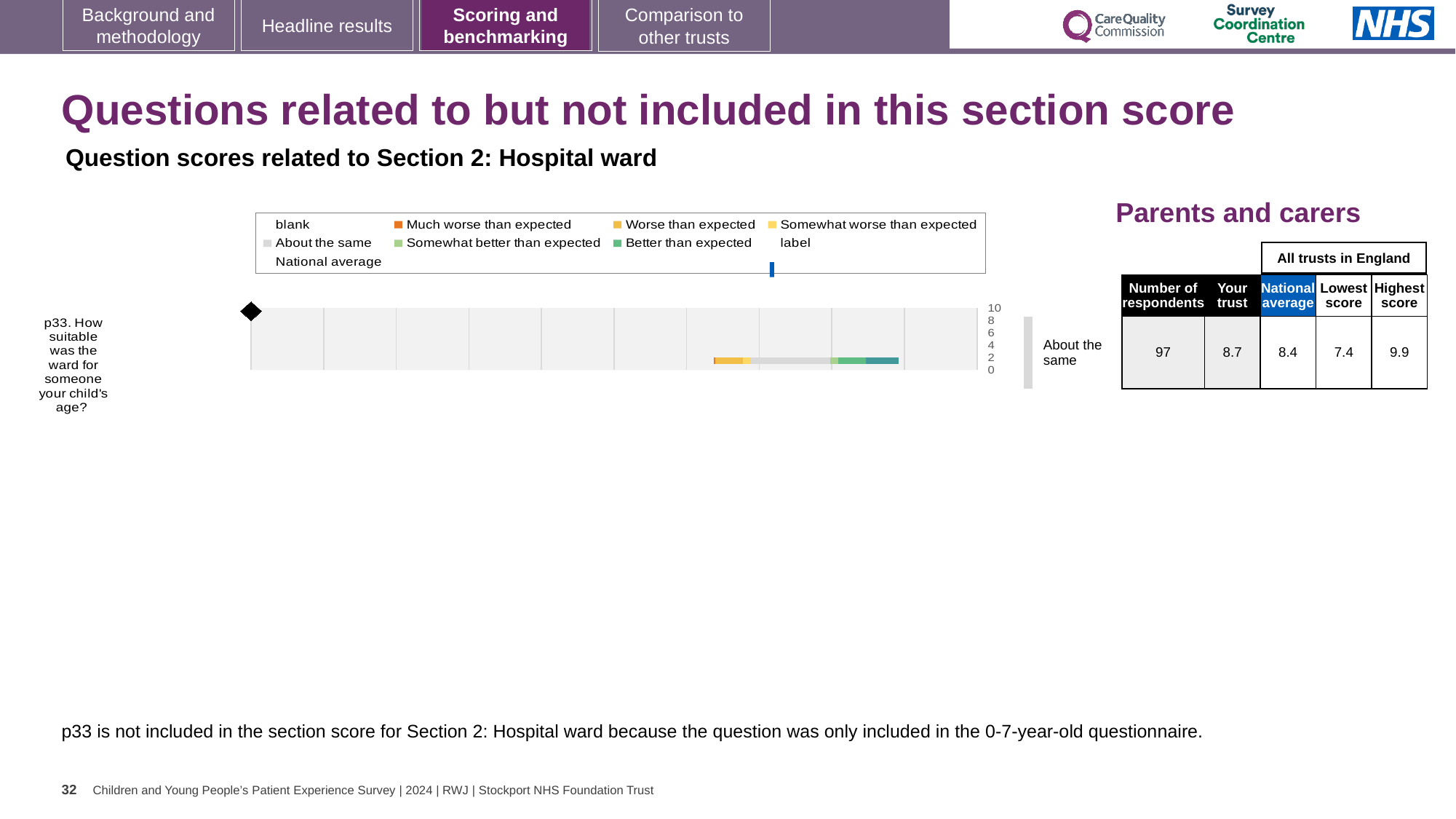
In the table next to the chart, how many respondents answered p33? 97 How many questions are plotted in the chart? 1 How many entries does the chart legend list? 9 In the table next to the chart, what is the highest score among all trusts in England for p33? 9.9 Which question is plotted in the chart? p33. How suitable was the ward for someone your child's age? For p33, which is larger: the 'Your trust' score or the national average? Your trust In the table next to the chart, what is the lowest score among all trusts in England for p33? 7.4 What kind of chart is used to show the p33 question score? bar chart In the table next to the chart, what is the national average score for p33? 8.4 In the table next to the chart, what is the 'Your trust' score for p33? 8.7 What benchmark category label is shown to the right of the p33 bar? About the same For p33, what is the difference between the highest score and the lowest score among all trusts in England? 2.5